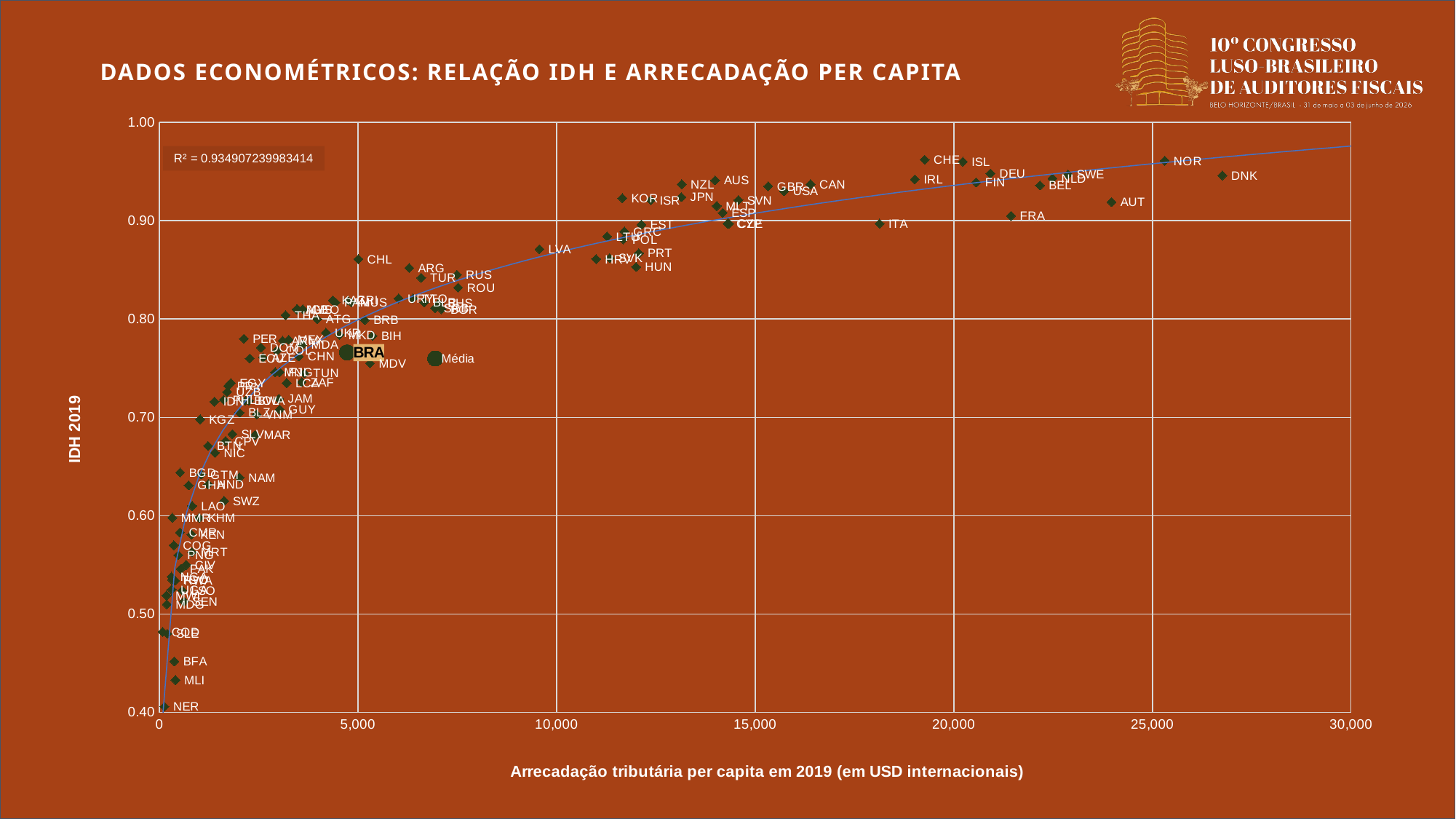
Is the IDH 2019 value for BRA greater or less than 0.80? less Is the arrecadação tributária per capita for NOR greater or less than 25,000? greater What is the R² value printed on the chart? R² = 0.934907239983414 Is the IDH 2019 value for CHL greater or less than 0.80? greater What is the title of the x axis? Arrecadação tributária per capita em 2019 (em USD internacionais) As arrecadação tributária per capita increases along the x axis, does IDH 2019 generally rise or fall? Rise Which country has the highest arrecadação tributária per capita on the chart? DNK Which country has the lowest IDH 2019 value on the chart? NER What kind of chart is shown on the slide? Scatter plot What is the title of the y axis? IDH 2019 Which has a higher arrecadação tributária per capita, FRA or ITA? FRA